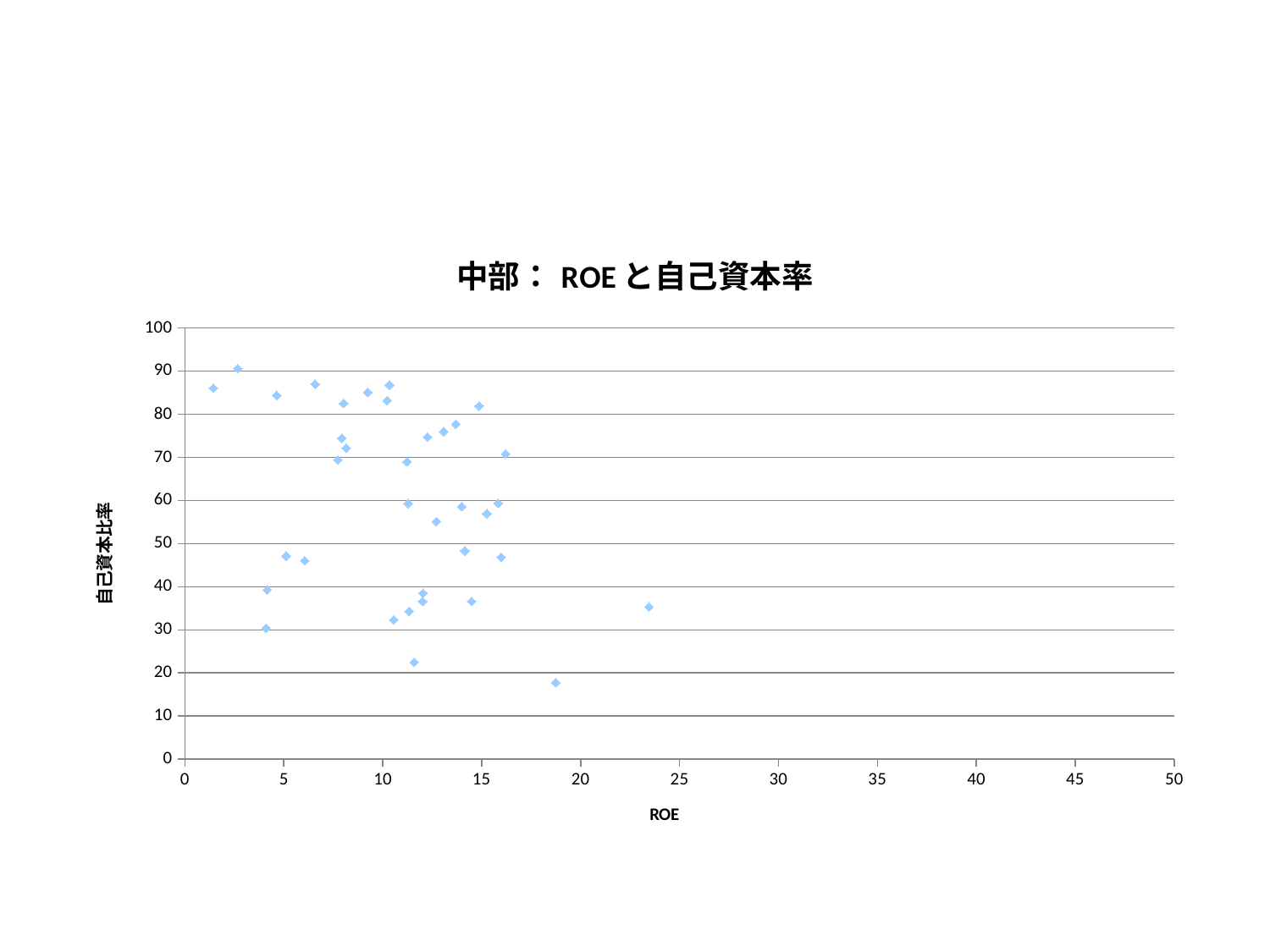
Is the largest ROE value plotted greater or less than 20? greater For the point with the lowest 自己資本比率, is its ROE greater or less than 15? greater Is the highest 自己資本比率 value plotted greater or less than 80? greater What is the label of the horizontal axis? ROE What is the title of the chart? 中部： ROE と自己資本率 What kind of chart is shown on the slide? scatter chart